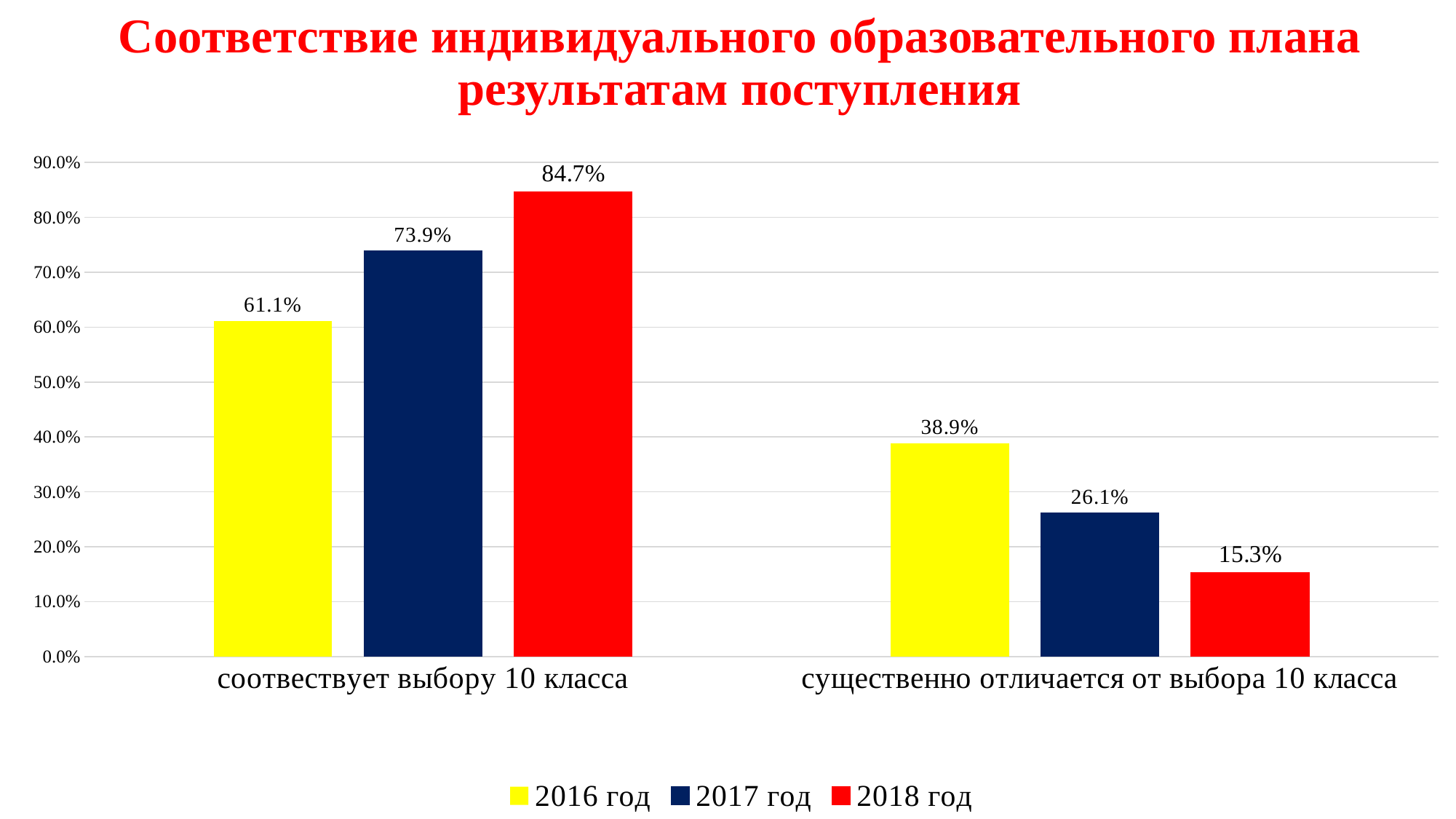
Which is larger: the 2017 год value for 'существенно отличается от выбора 10 класса' or the 2016 год value for 'соотвествует выбору 10 класса'? 2016 год value for 'соотвествует выбору 10 класса' Which colour represents 2017 год in the legend? Dark blue What is the value for 2016 год in the category 'существенно отличается от выбора 10 класса'? 38.9% What is the difference between the 2016 год and 2017 год values in the category 'существенно отличается от выбора 10 класса'? 12.8% What kind of chart is shown on the slide? Bar chart How many series does the legend list? 3 How many categories are shown on the x axis? 2 Which year has the lowest value in the category 'существенно отличается от выбора 10 класса'? 2018 год Which year has the highest value in the category 'соотвествует выбору 10 класса'? 2018 год What is the value for 2017 год in the category 'соотвествует выбору 10 класса'? 73.9% What is the difference between the 2018 год and 2016 год values in the category 'соотвествует выбору 10 класса'? 23.6% What is the value for 2018 год in the category 'соотвествует выбору 10 класса'? 84.7%